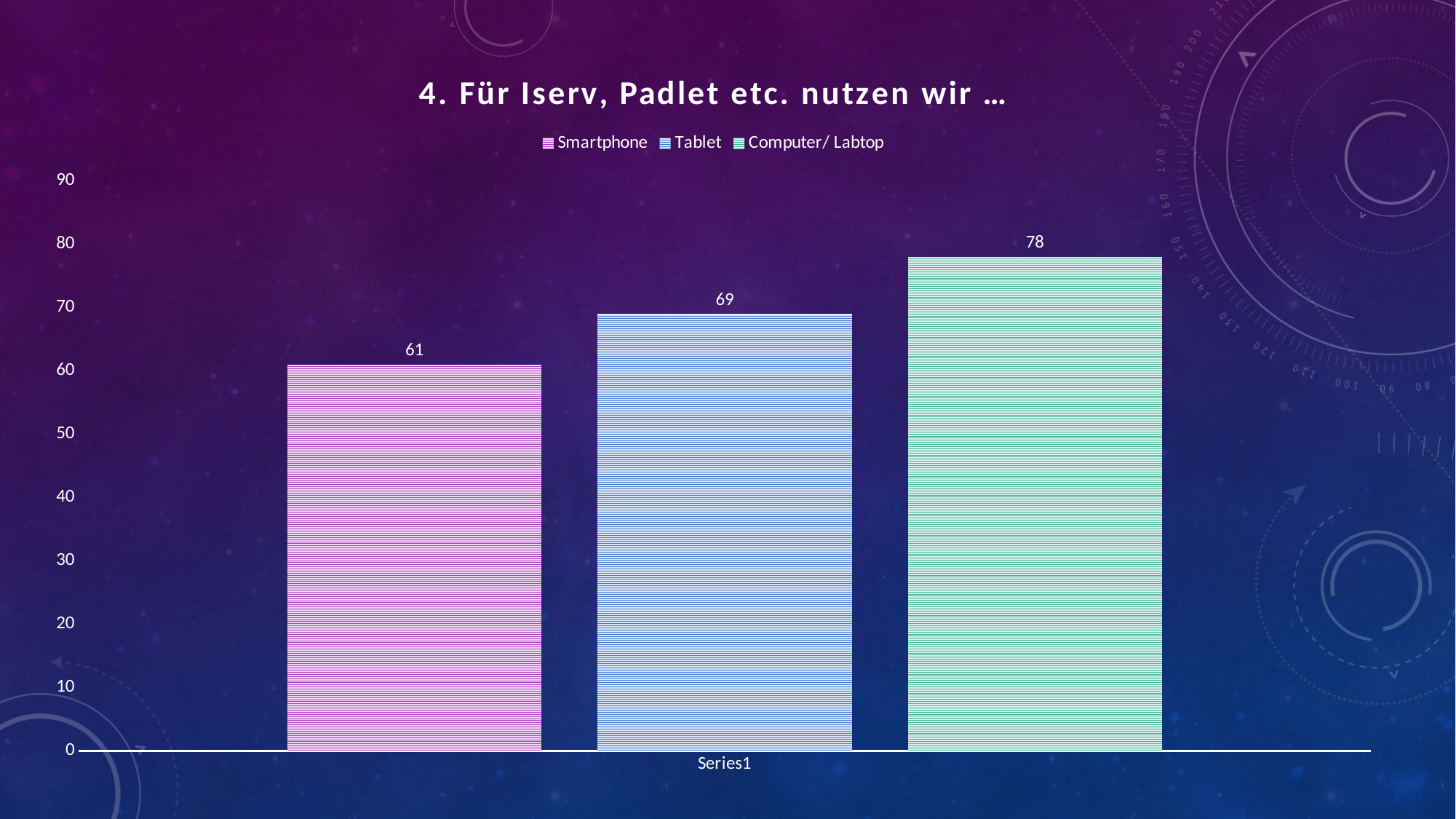
What is the title of the chart? 4. Für Iserv, Padlet etc. nutzen wir … What kind of chart is shown on the slide? bar chart What is the difference between the values for Computer/ Labtop and Smartphone? 17 Which series has the lowest value? Smartphone How many series does the legend list? 3 What is the value for Tablet? 69 What is the value for Smartphone? 61 Which is larger, the value for Tablet or the value for Smartphone? Tablet Which series has the highest value? Computer/ Labtop Is the value for Computer/ Labtop greater or less than 70? greater What is the value for Computer/ Labtop? 78 What is the difference between the values for Tablet and Smartphone? 8